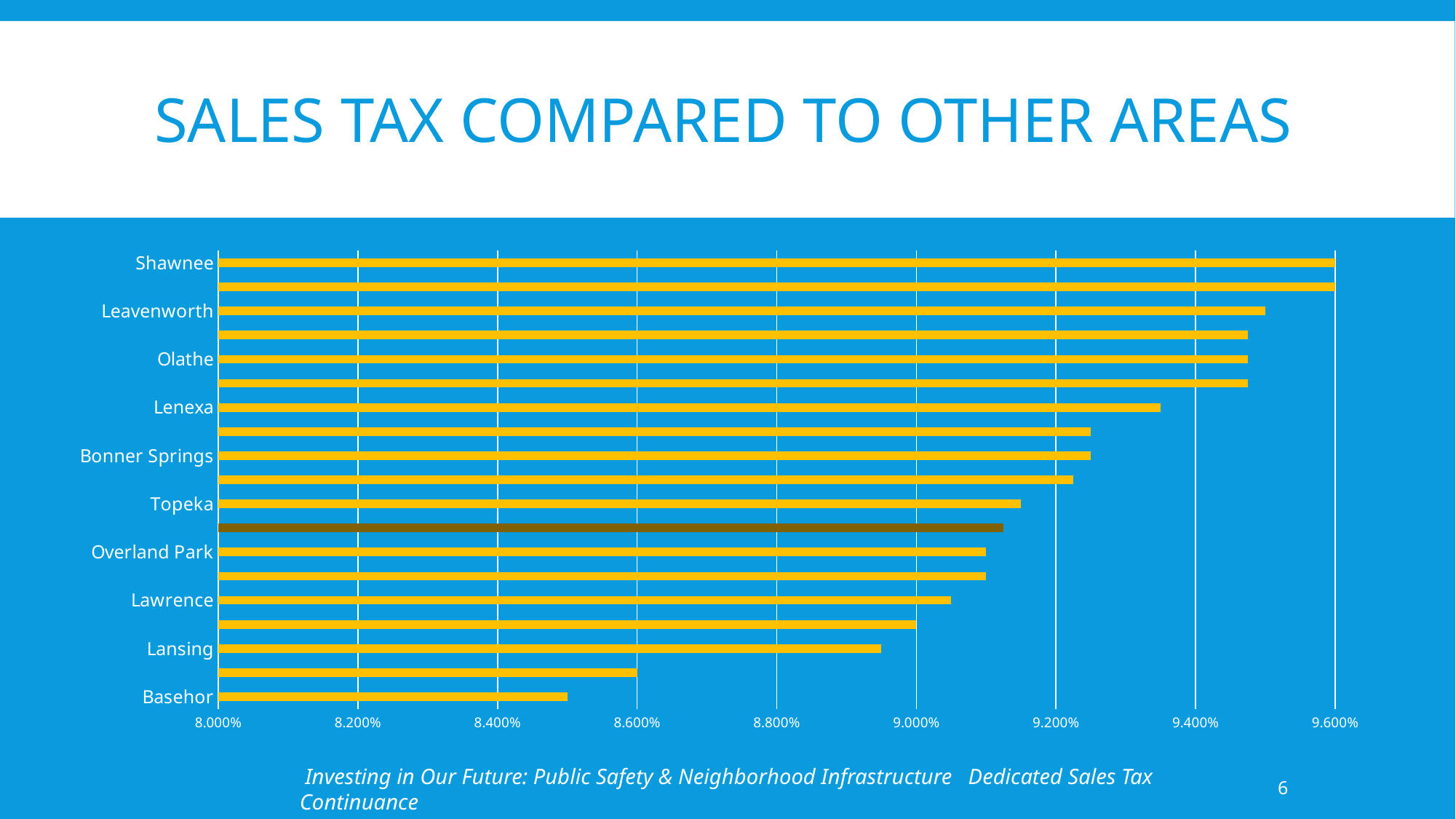
Is the value for Leavenworth greater or less than 9.400%? greater Which labeled area has the highest sales tax rate? Shawnee Which labeled area has the lowest sales tax rate? Basehor Is the value for Basehor greater or less than 8.600%? less What is the title of the slide's chart? SALES TAX COMPARED TO OTHER AREAS Which has a higher sales tax rate, Lansing or Basehor? Lansing What kind of chart is shown on the slide? bar chart Which has a higher sales tax rate, Leavenworth or Lenexa? Leavenworth Is the value for Lenexa greater or less than 9.400%? less What is the sales tax rate for Shawnee? 9.600% How many area labels are shown on the vertical axis? 10